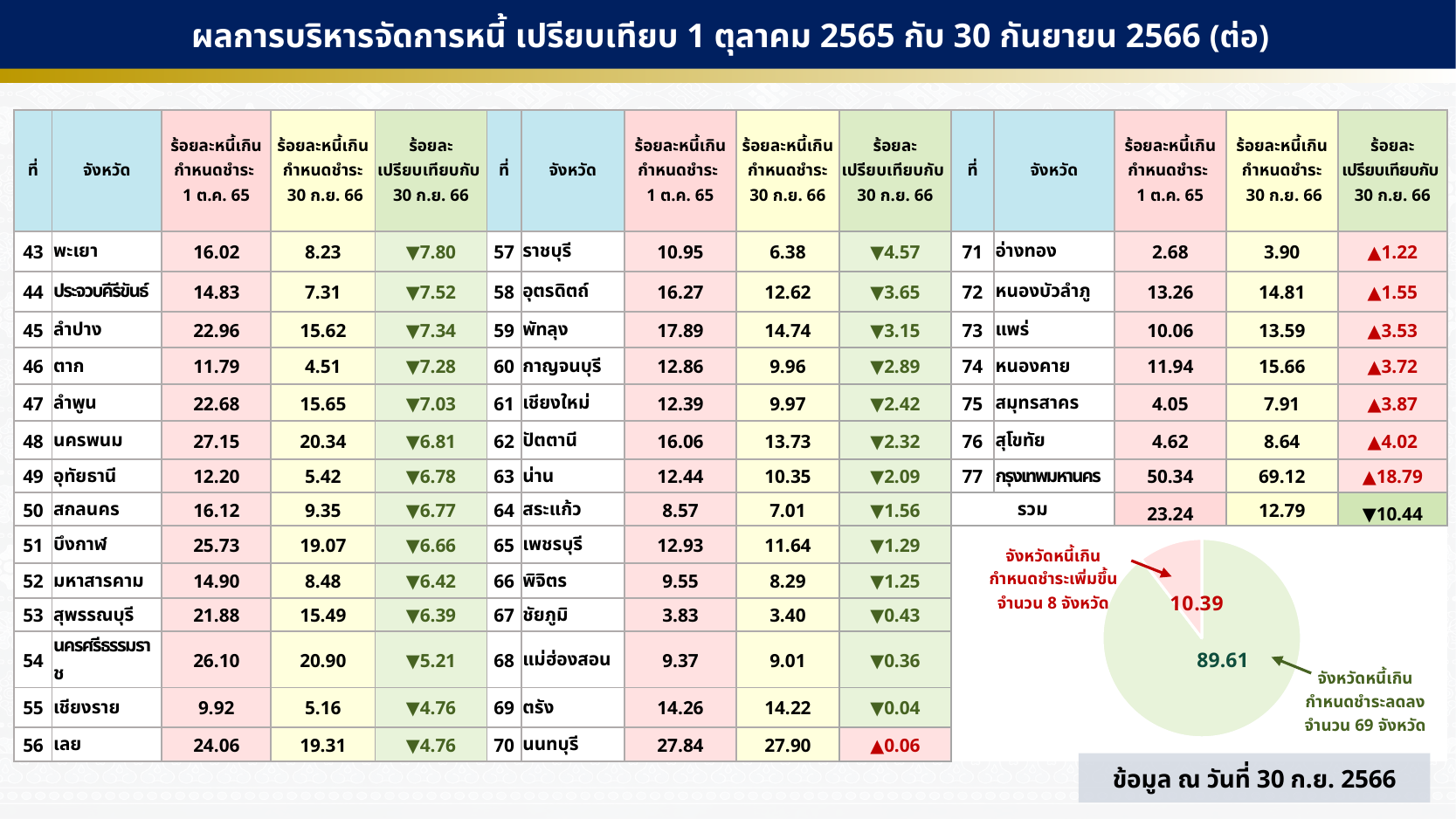
What type of chart is shown at the bottom right of the slide? pie chart In the pie chart, is the slice for provinces with decreased overdue debt larger or smaller than the slice for provinces with increased overdue debt? larger How many slices does the pie chart have? 2 What share of the pie chart is taken by the slice for provinces with increased overdue debt? 10.39 In the pie chart, what value is shown for the slice labelled จังหวัดหนี้เกินกำหนดชำระเพิ่มขึ้น (provinces with increased overdue debt)? 10.39 According to the pie chart annotation, how many provinces had increased overdue debt? 8 จังหวัด In the pie chart, what is the difference between the 89.61 slice and the 10.39 slice? 79.22 In the pie chart, what value is shown for the slice labelled จังหวัดหนี้เกินกำหนดชำระลดลง (provinces with decreased overdue debt)? 89.61 According to the pie chart annotation, how many provinces had decreased overdue debt? 69 จังหวัด Which slice of the pie chart is the largest? จังหวัดหนี้เกินกำหนดชำระลดลง (89.61) Which slice of the pie chart is the smallest? จังหวัดหนี้เกินกำหนดชำระเพิ่มขึ้น (10.39)